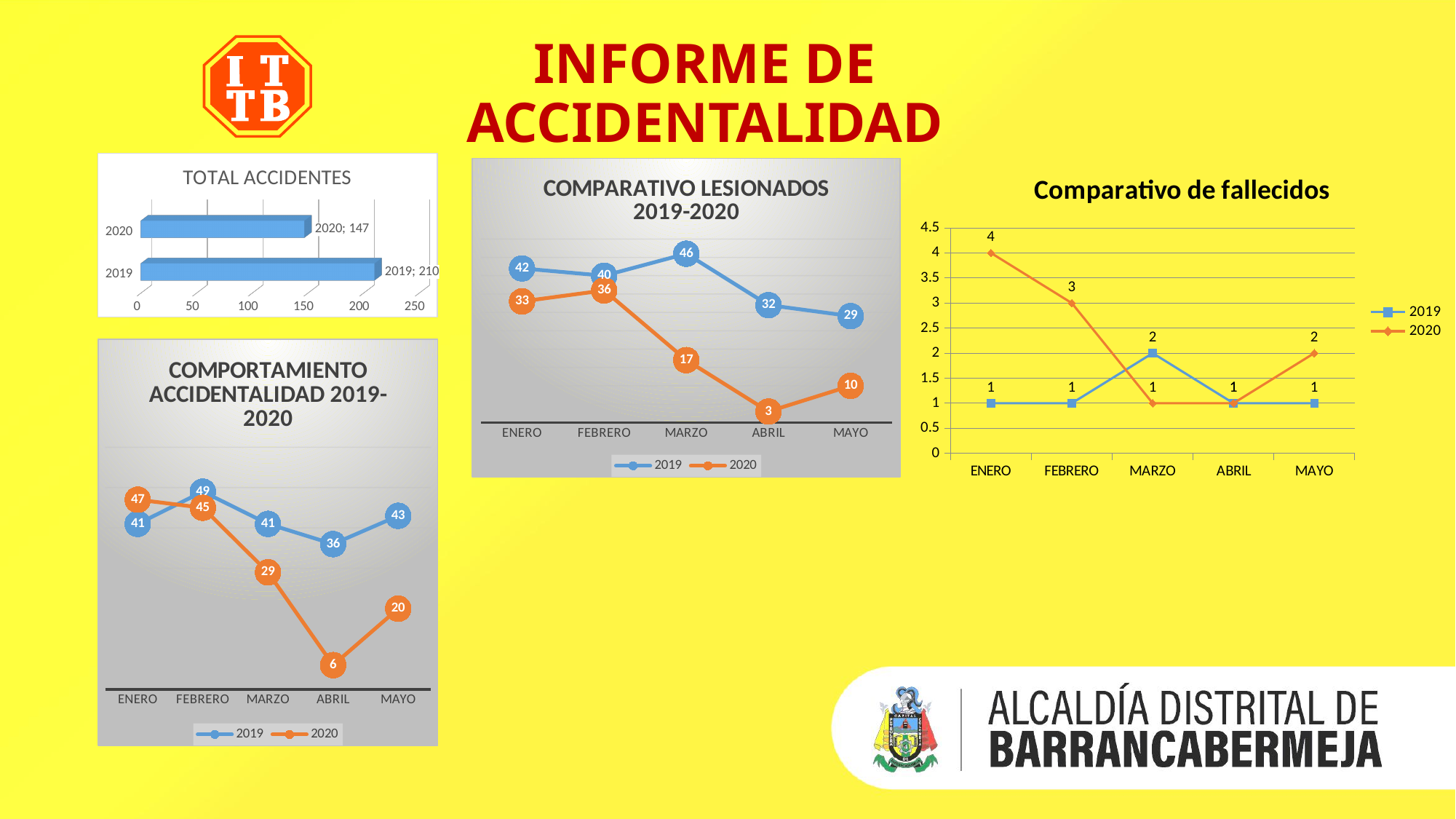
In the 'COMPORTAMIENTO ACCIDENTALIDAD 2019-2020' chart, how many months are shown on the x axis? 5 In the 'Comparativo de fallecidos' chart, what is the 2020 value for ENERO? 4 In the 'COMPARATIVO LESIONADOS 2019-2020' chart, which month has the lowest 2020 value? ABRIL In the 'COMPARATIVO LESIONADOS 2019-2020' chart, what is the 2019 value for MARZO? 46 In the 'TOTAL ACCIDENTES' chart, what is the difference between the 2019 and 2020 values? 63 How many series does the legend of the 'Comparativo de fallecidos' chart list? 2 In the 'COMPARATIVO LESIONADOS 2019-2020' chart, what is the difference between the 2019 and 2020 values for MAYO? 19 What kind of chart is the 'TOTAL ACCIDENTES' chart? Bar chart In the 'COMPORTAMIENTO ACCIDENTALIDAD 2019-2020' chart, which month has the highest 2019 value? FEBRERO In the 'Comparativo de fallecidos' chart, which series has the larger value in MARZO, 2019 or 2020? 2019 In the 'COMPORTAMIENTO ACCIDENTALIDAD 2019-2020' chart, what is the 2020 value for ABRIL? 6 In the 'TOTAL ACCIDENTES' chart, what is the value for 2019? 210